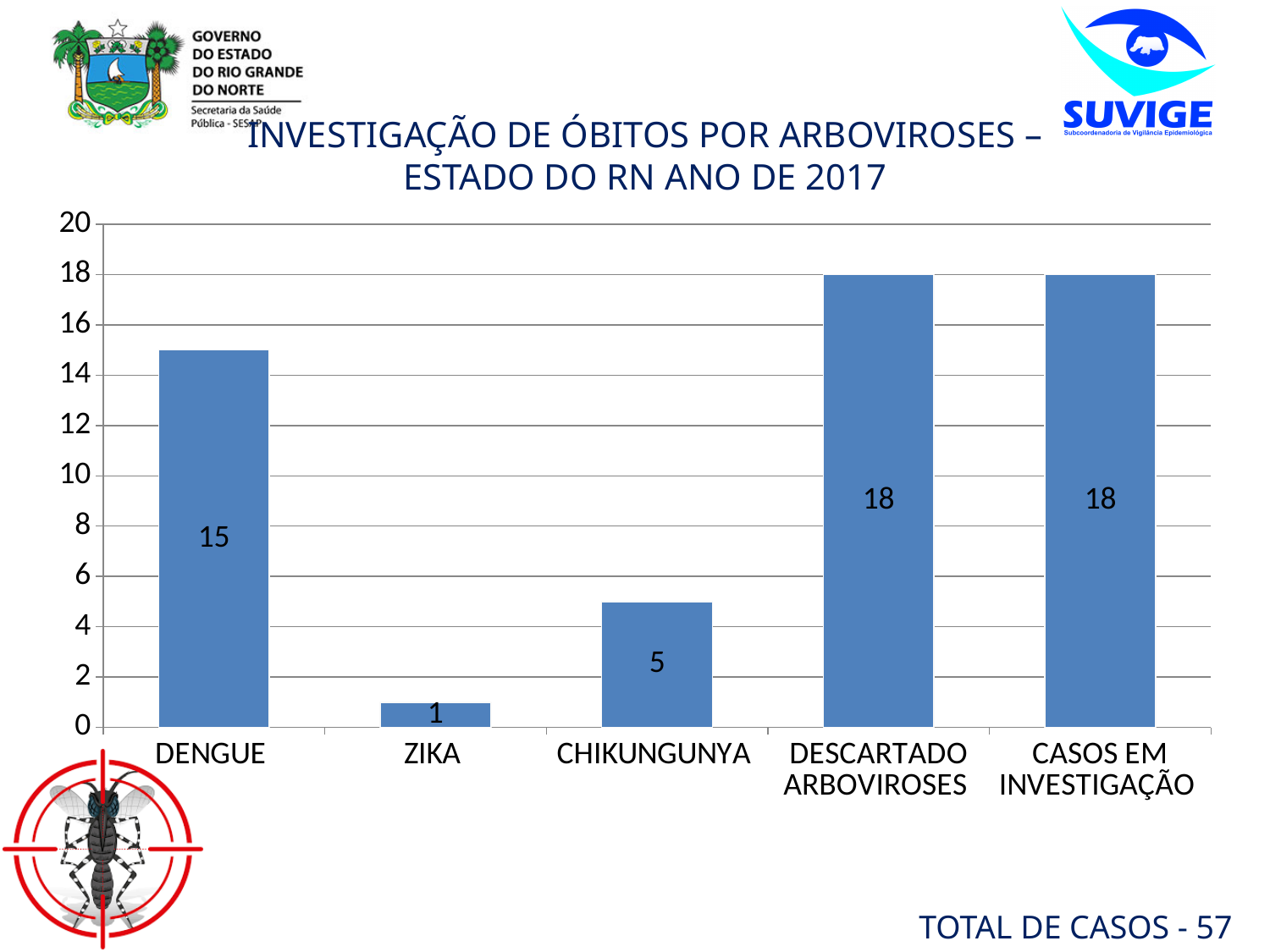
Which is larger, the value for DENGUE or the value for CHIKUNGUNYA? DENGUE What is the value for DENGUE? 15 Which category has the lowest value? ZIKA What is the value for CHIKUNGUNYA? 5 What is the difference between the values for CASOS EM INVESTIGAÇÃO and DENGUE? 3 What kind of chart is shown on the slide? bar chart What is the value for ZIKA? 1 What total number of cases is stated at the bottom of the slide? 57 What is the value for DESCARTADO ARBOVIROSES? 18 What is the difference between the values for DENGUE and CHIKUNGUNYA? 10 How many categories are shown on the x axis? 5 Is the value for DENGUE greater or less than 10? greater